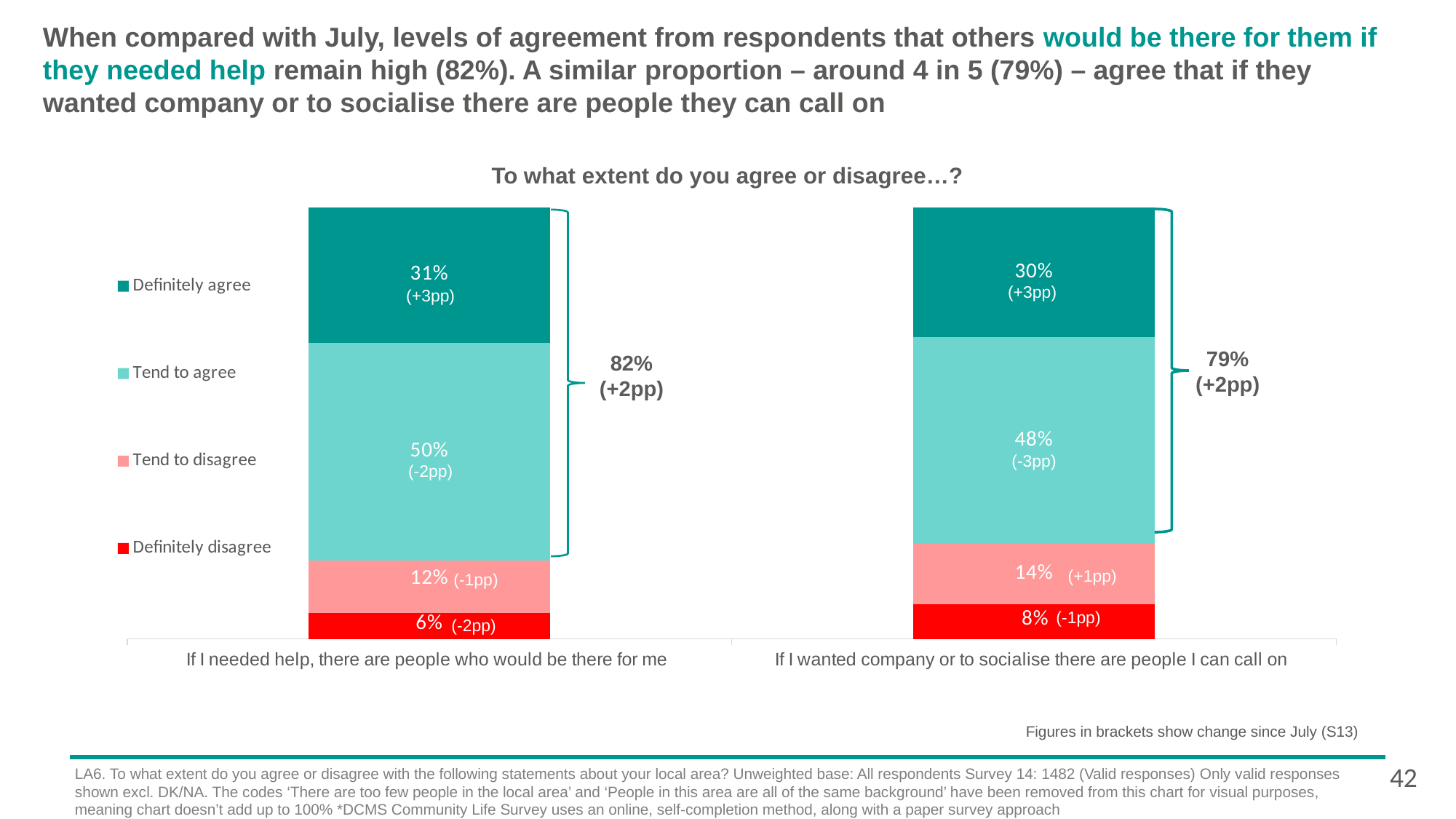
What is the difference in the 'Tend to disagree' percentage between the two statements? 2 percentage points Which response category is the largest for the statement 'If I needed help, there are people who would be there for me'? Tend to agree What kind of chart is shown on the slide? Stacked bar chart What percentage of respondents 'Definitely agree' that if they needed help, there are people who would be there for them? 31% What percentage 'Tend to agree' with the statement 'If I wanted company or to socialise there are people I can call on'? 48% Which statement has the larger 'Tend to agree' percentage? If I needed help, there are people who would be there for me What is the title of the chart? To what extent do you agree or disagree…? How many response categories does the legend list? 4 What is the change since July shown for 'Definitely agree' on the statement 'If I needed help, there are people who would be there for me'? +3pp What is the combined agreement figure shown beside the bar for 'If I wanted company or to socialise there are people I can call on'? 79% What percentage 'Definitely disagree' with the statement 'If I needed help, there are people who would be there for me'? 6% How many statements (bars) are plotted in the chart? 2